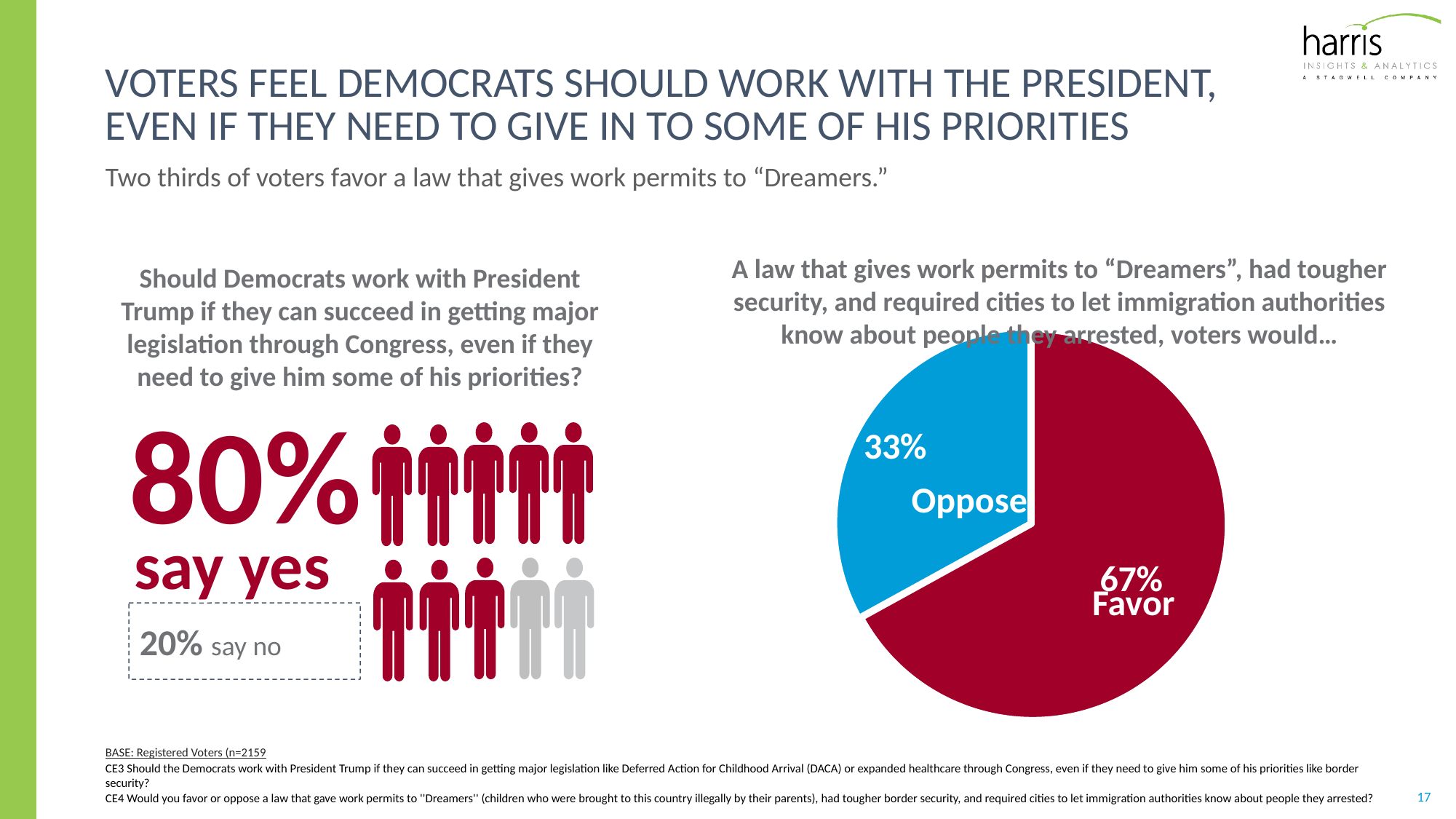
What type of chart is shown on the right side of the slide? Pie chart On the pie chart on the right, what share of voters favor the law that gives work permits to "Dreamers"? 67% How many slices does the pie chart on the right have? 2 On the left infographic, what percentage of voters say no? 20% On the pie chart on the right, which response has the smallest share? Oppose On the left infographic, what is the difference in percentage points between those who say yes and those who say no? 60 percentage points On the pie chart on the right, what colour is the Oppose slice? Blue On the pie chart on the right, what colour is the Favor slice? Red On the pie chart on the right, what share of voters oppose the law? 33% On the pie chart on the right, which slice is larger, Favor or Oppose? Favor On the left infographic, what percentage of voters say yes to Democrats working with President Trump? 80% On the pie chart on the right, what is the difference in percentage points between Favor and Oppose? 34 percentage points